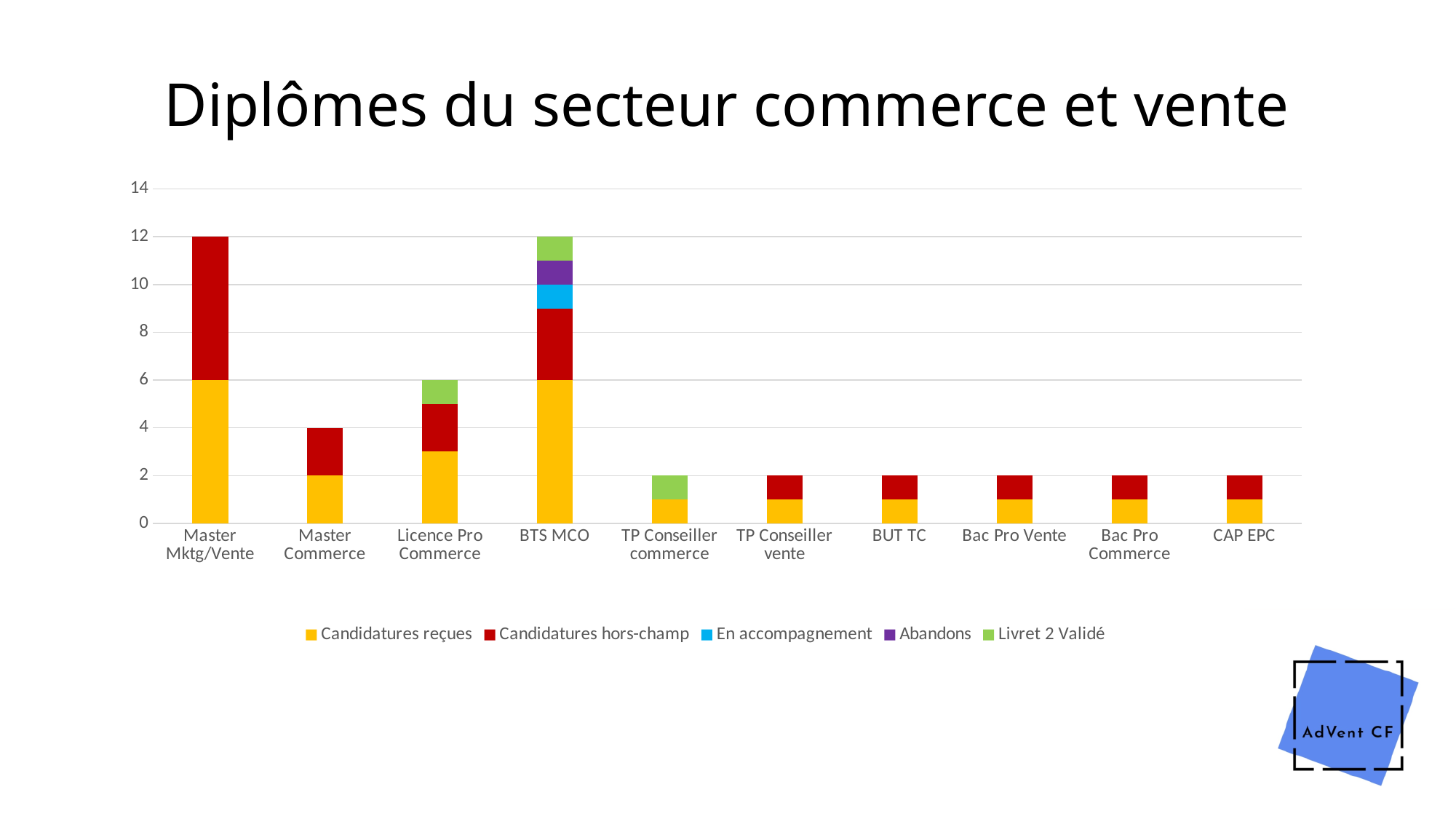
What is the total height of the stacked bar for BTS MCO? 12 How many series does the legend list? 5 What is the total height of the stacked bar for Master Commerce? 4 What is the value of Candidatures reçues for BTS MCO? 6 Which colour represents Abandons in the legend? Purple What kind of chart is shown on the slide? Stacked bar chart What is the total height of the stacked bar for Master Mktg/Vente? 12 What is the title of the chart? Diplômes du secteur commerce et vente Is the value of Candidatures reçues for Licence Pro Commerce greater or less than 4? less How many diploma categories are shown on the x axis? 10 Which has a taller stacked bar in total, Licence Pro Commerce or Master Commerce? Licence Pro Commerce What is the value of Candidatures reçues for Master Mktg/Vente? 6